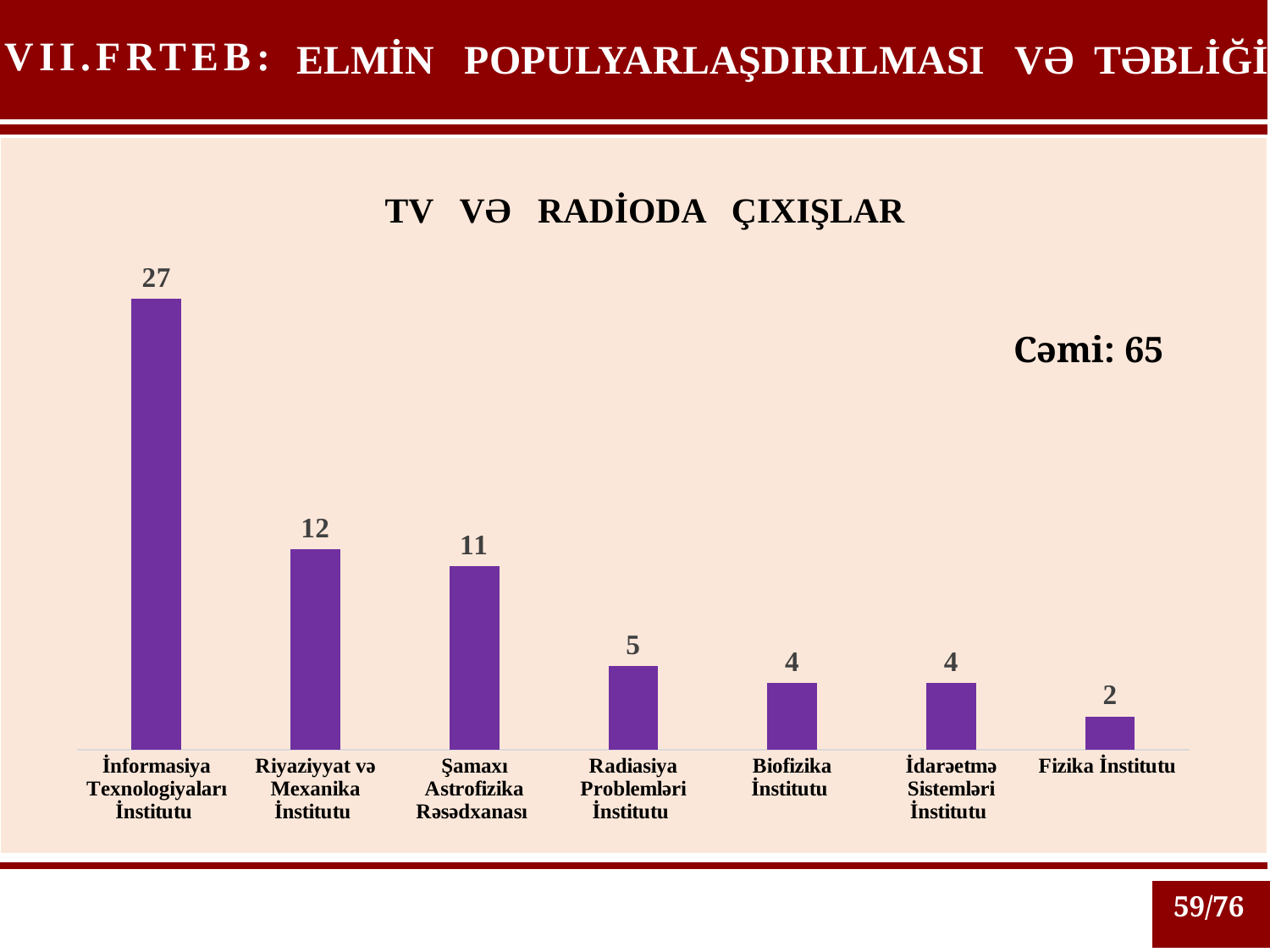
Which category has the lowest value? Fizika İnstitutu How many categories are shown in the chart? 7 Which is larger, the value for Radiasiya Problemləri İnstitutu or the value for Biofizika İnstitutu? Radiasiya Problemləri İnstitutu What total (Cəmi) is printed on the chart? 65 What is the title of the chart? TV VƏ RADİODA ÇIXIŞLAR Do the values rise or fall from left to right along the x axis? fall What is the difference between the values for İnformasiya Texnologiyaları İnstitutu and Riyaziyyat və Mexanika İnstitutu? 15 Which category has the highest value? İnformasiya Texnologiyaları İnstitutu What kind of chart is shown on the slide? bar chart What is the value for Şamaxı Astrofizika Rəsədxanası? 11 What is the value for Fizika İnstitutu? 2 What is the value for İnformasiya Texnologiyaları İnstitutu? 27